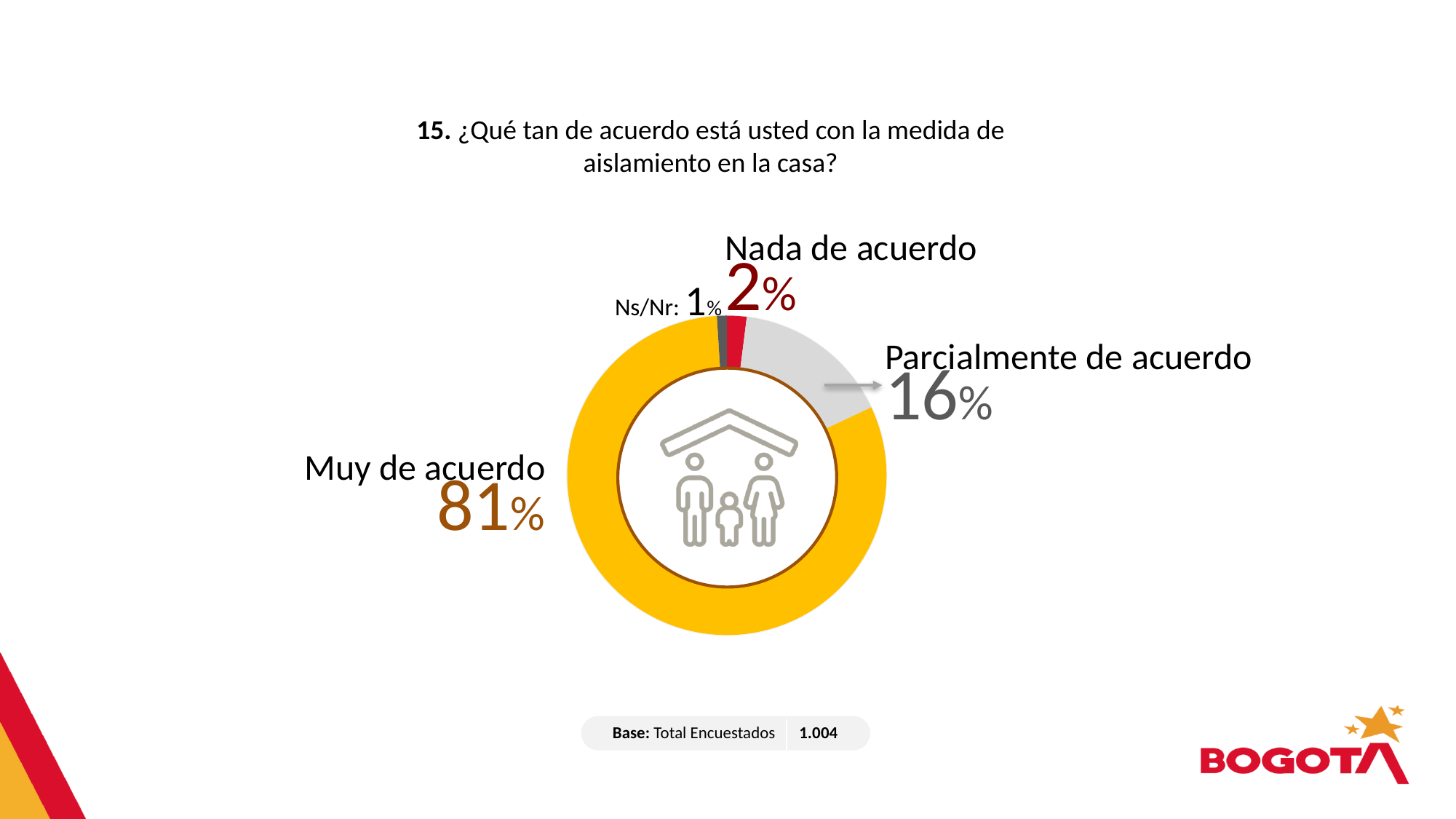
Which is larger, the share for "Parcialmente de acuerdo" or the share for "Nada de acuerdo"? Parcialmente de acuerdo How many response categories are shown in the chart? 4 What kind of chart is shown on the slide? Pie chart (donut) What is the base (total respondents) stated on the slide? 1.004 Which response category has the largest share of the chart? Muy de acuerdo What percentage of respondents answered "Parcialmente de acuerdo"? 16% What colour is the "Muy de acuerdo" segment of the chart? Yellow What percentage of respondents answered "Muy de acuerdo"? 81% Which response category has the smallest share of the chart? Ns/Nr What percentage of respondents answered "Nada de acuerdo"? 2% What is the difference in percentage points between "Muy de acuerdo" and "Parcialmente de acuerdo"? 65 What percentage of respondents are shown as "Ns/Nr"? 1%